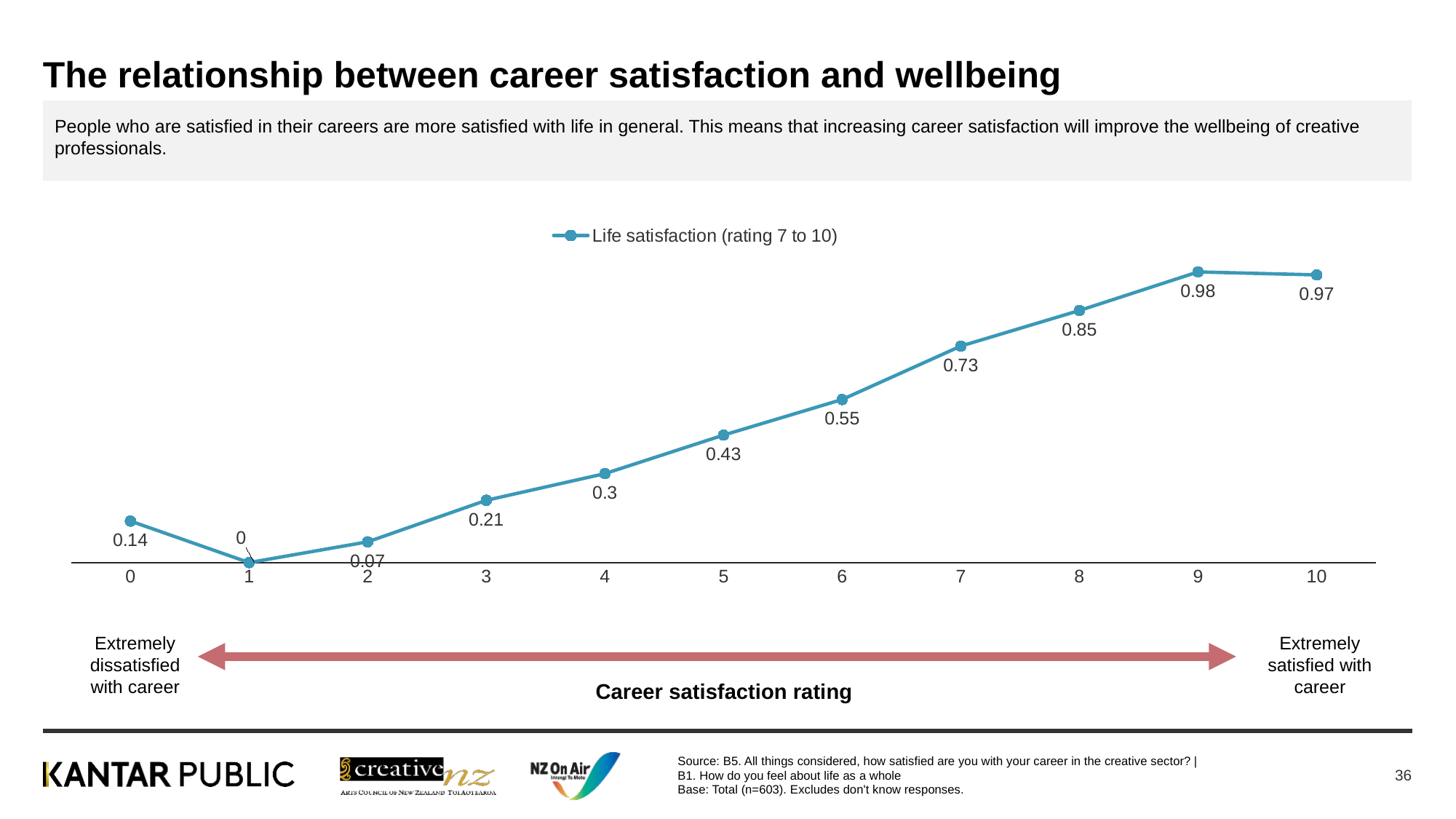
Which has a larger life satisfaction value: rating 3 or rating 4? rating 4 How many career satisfaction rating points are plotted on the chart? 11 What kind of chart is shown on the slide? line chart How many series does the legend list? 1 Which career satisfaction rating has the highest life satisfaction value? 9 What is the name of the series shown in the legend? Life satisfaction (rating 7 to 10) What is the life satisfaction value at a career satisfaction rating of 8? 0.85 What is the life satisfaction value at a career satisfaction rating of 0? 0.14 What is the difference between the life satisfaction values at ratings 7 and 6? 0.18 Do the life satisfaction values generally rise or fall as the career satisfaction rating increases from 1 to 9? rise Which career satisfaction rating has the lowest life satisfaction value? 1 What is the life satisfaction value at a career satisfaction rating of 5? 0.43